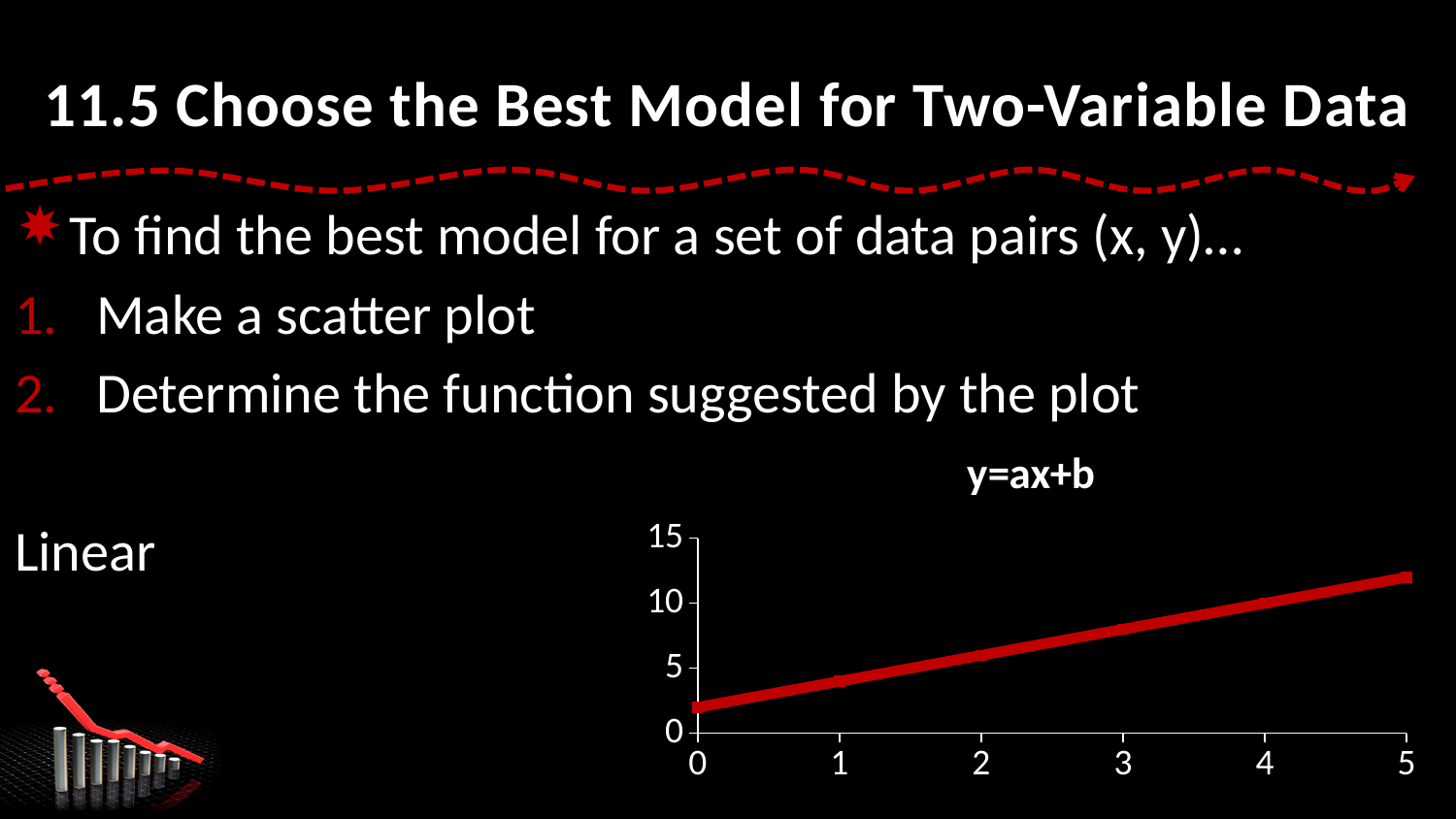
Which is larger, the value of the line at x=5 or at x=1? x=5 Is the value of the line at x=2 greater or less than 10? less What is the title of the chart? y=ax+b What is the highest tick value shown on the y axis? 15 At which x value does the line reach its highest point? 5 Is the value of the line at x=0 greater or less than 5? less Is the value of the line at x=5 greater or less than 10? greater Do the values on the chart rise or fall as x increases from 0 to 5? rise At which x value is the line at its lowest point? 0 What kind of chart is shown on the slide? line chart